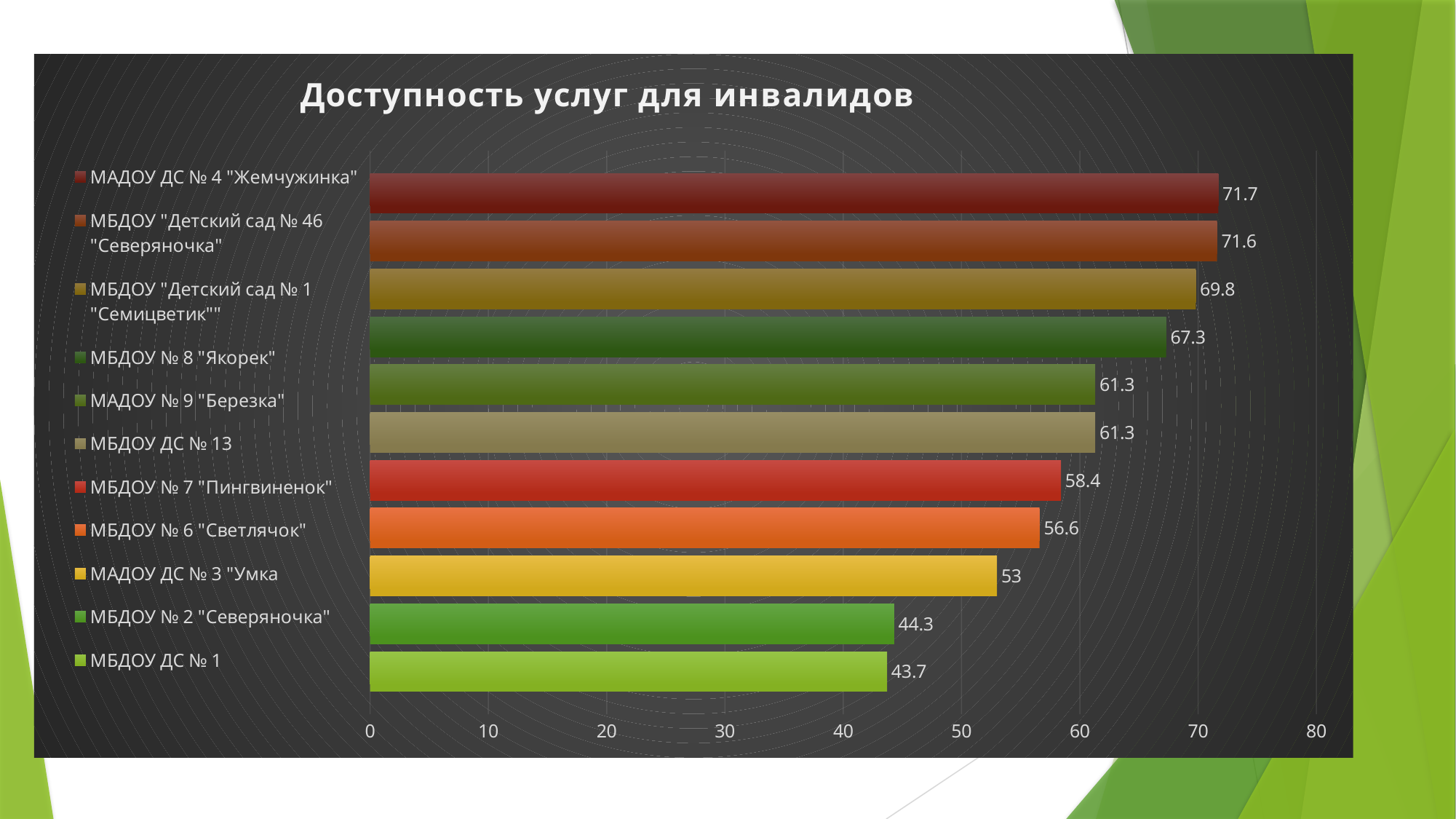
Which category has the lowest value? МБДОУ ДС № 1 What is the difference between the values for МБДОУ № 7 "Пингвиненок" and МБДОУ № 6 "Светлячок"? 1.8 How many categories are shown in the chart? 11 What is the title of the chart? Доступность услуг для инвалидов Is the value for МАДОУ № 9 "Березка" greater or less than 60? greater What is the difference between the values for МАДОУ ДС № 4 "Жемчужинка" and МБДОУ ДС № 1? 28 Which is larger, the value for МБДОУ № 2 "Северяночка" or the value for МАДОУ ДС № 3 "Умка"? МАДОУ ДС № 3 "Умка" What kind of chart is shown on the slide? bar chart Which category has the highest value? МАДОУ ДС № 4 "Жемчужинка" What is the value for МАДОУ ДС № 3 "Умка"? 53 What is the value for МБДОУ № 8 "Якорек"? 67.3 What is the value for МБДОУ № 6 "Светлячок"? 56.6